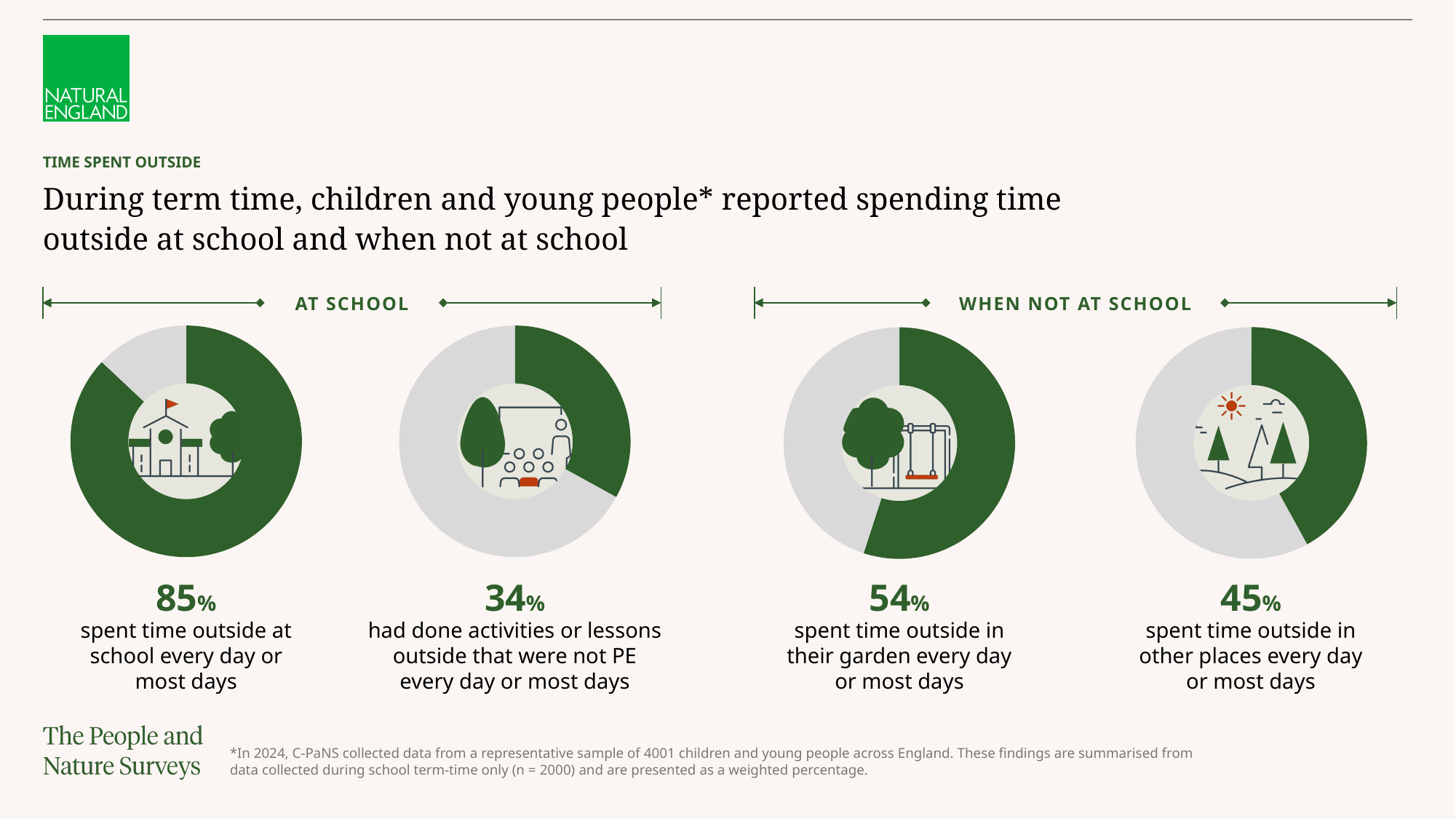
What is the difference in percentage points between spending time outside at school every day or most days and doing non-PE activities or lessons outside every day or most days? 51 What percentage spent time outside in other places every day or most days? 45% Which of the four donut charts shows the lowest percentage? had done activities or lessons outside that were not PE every day or most days (34%) Which is larger: the percentage who spent time outside in their garden every day or most days, or the percentage who spent time outside in other places every day or most days? in their garden (54%) What percentage spent time outside in their garden every day or most days? 54% Which of the four donut charts shows the highest percentage? spent time outside at school every day or most days (85%) What kind of chart is used to show each percentage on the slide? donut (pie) chart What percentage had done activities or lessons outside that were not PE every day or most days? 34% What is the difference in percentage points between spending time outside in their garden and spending time outside in other places every day or most days? 9 Under which heading are the 54% and 45% donut charts grouped? WHEN NOT AT SCHOOL What percentage of children and young people spent time outside at school every day or most days? 85% How many donut charts are shown on the slide? 4